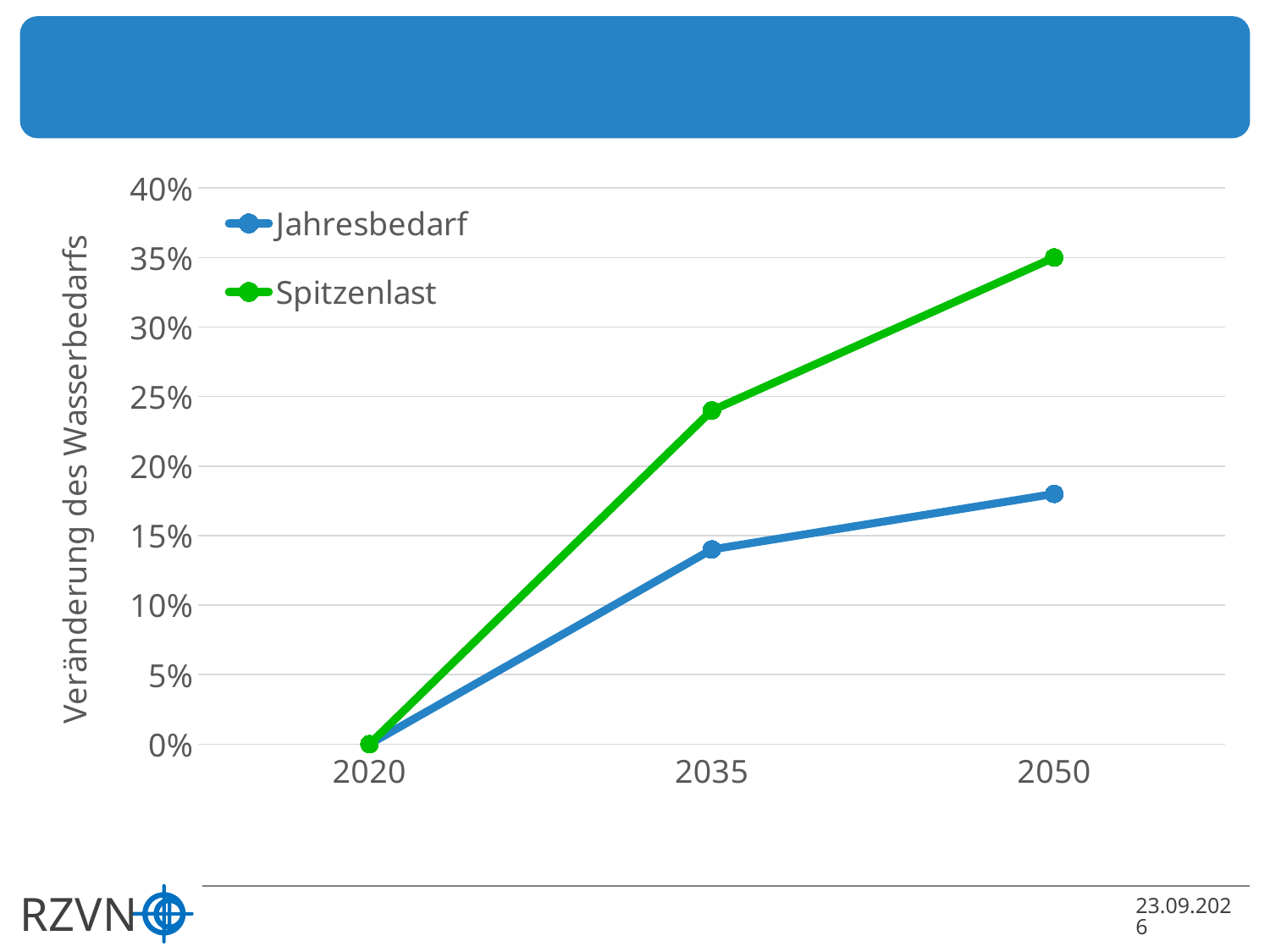
Is the value for Spitzenlast in 2035 greater or less than 20%? greater Which series has the higher value in 2050, Jahresbedarf or Spitzenlast? Spitzenlast How many points along the x axis does each line have? 3 Do the values of Spitzenlast rise or fall from 2020 to 2050? rise What is the value of Spitzenlast in 2020? 0% Is the value for Jahresbedarf in 2050 greater or less than 20%? less What is the label of the y axis? Veränderung des Wasserbedarfs What kind of chart is shown on the slide? line chart Is the value for Jahresbedarf in 2035 greater or less than 15%? less What is the value of Spitzenlast in 2050? 35% How many series does the legend list? 2 What is the value of Jahresbedarf in 2020? 0%